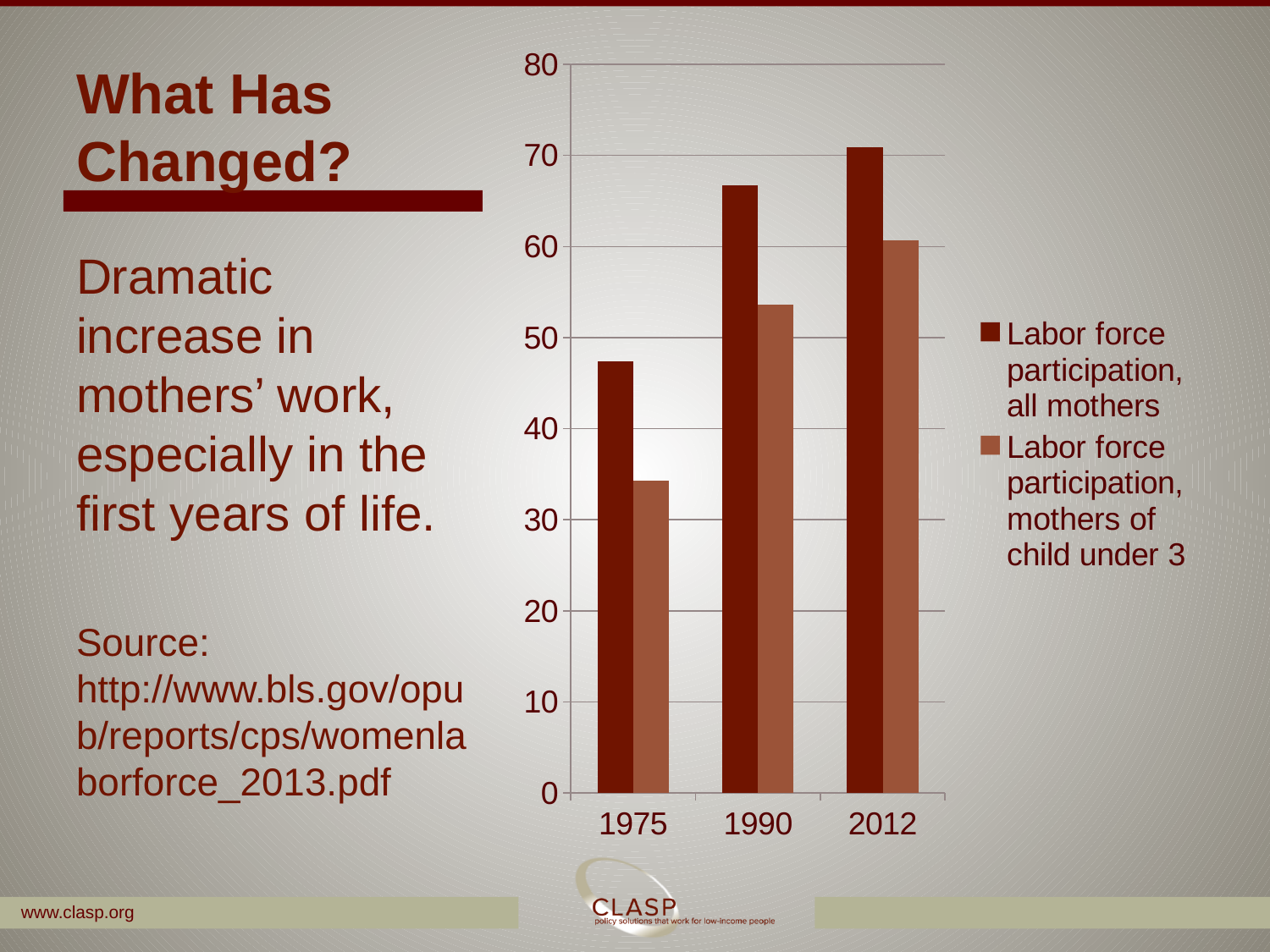
Do the values for labor force participation, all mothers rise or fall from 1975 to 2012? rise How many series does the legend list? 2 Which series is shown in the darker red bars? Labor force participation, all mothers Is the value for labor force participation, mothers of child under 3 in 1975 greater or less than 40? less Is the value for labor force participation, all mothers in 2012 greater or less than 70? greater Which year has the lowest value for labor force participation, mothers of child under 3? 1975 How many years are shown on the x axis? 3 Is the value for labor force participation, mothers of child under 3 in 1990 greater or less than 50? greater Which year has the highest value for labor force participation, all mothers? 2012 What kind of chart is shown on the slide? bar chart In 1990, which is larger: labor force participation for all mothers or for mothers of child under 3? all mothers